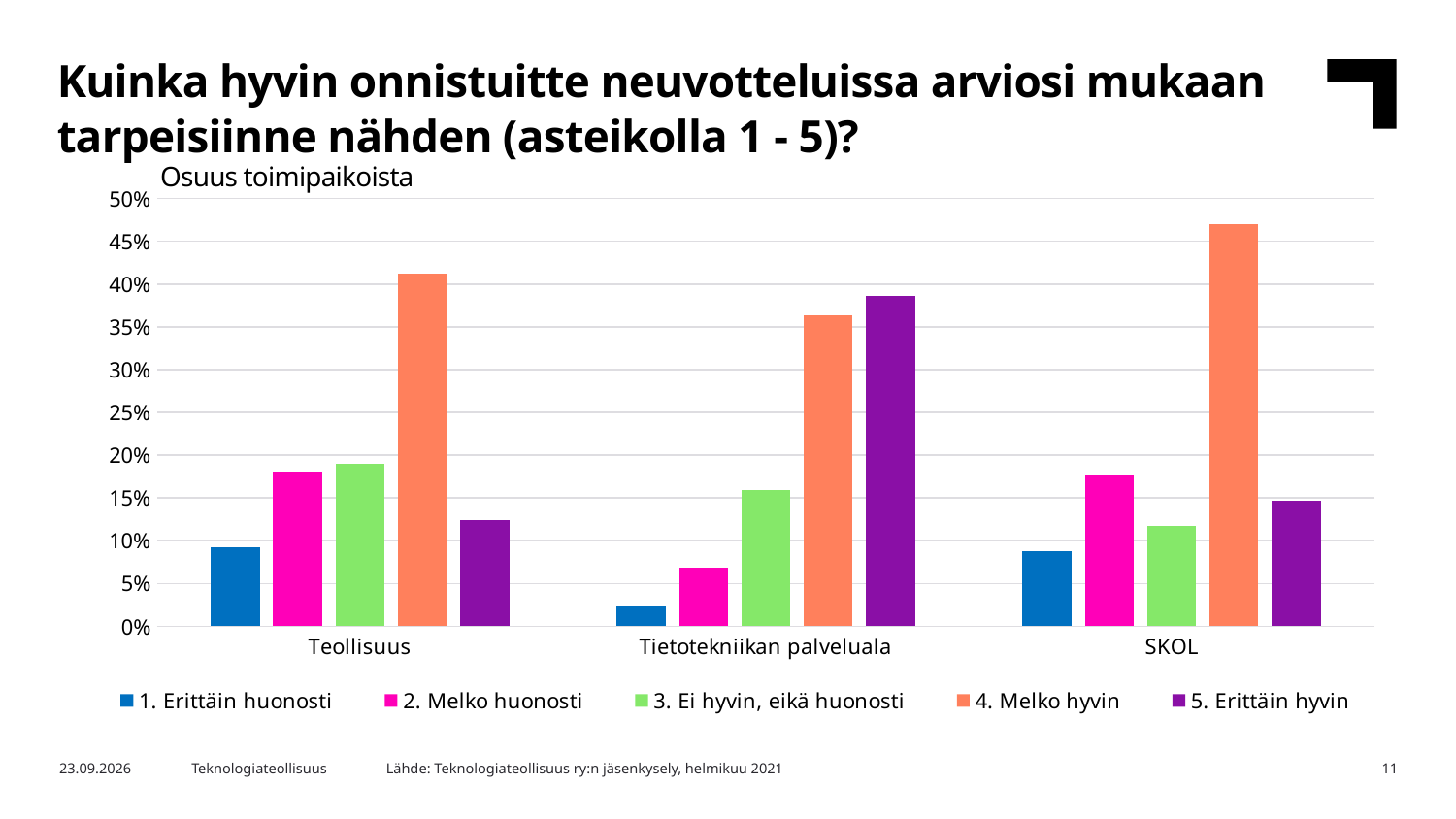
Which category has the highest value for the series "4. Melko hyvin"? SKOL What is the label shown on the vertical axis of the chart? Osuus toimipaikoista What kind of chart is shown on the slide? bar chart Which is larger in Tietotekniikan palveluala: "4. Melko hyvin" or "5. Erittäin hyvin"? 5. Erittäin hyvin Which category has the lowest value for the series "1. Erittäin huonosti"? Tietotekniikan palveluala Is the value for "5. Erittäin hyvin" in Tietotekniikan palveluala greater or less than 35%? greater Which is larger in SKOL: "2. Melko huonosti" or "3. Ei hyvin, eikä huonosti"? 2. Melko huonosti Is the value for "4. Melko hyvin" in SKOL greater or less than 45%? greater How many categories are shown on the x axis? 3 Which series is the highest in the Teollisuus category? 4. Melko hyvin Is the value for "1. Erittäin huonosti" in Teollisuus greater or less than 10%? less How many series does the legend list? 5